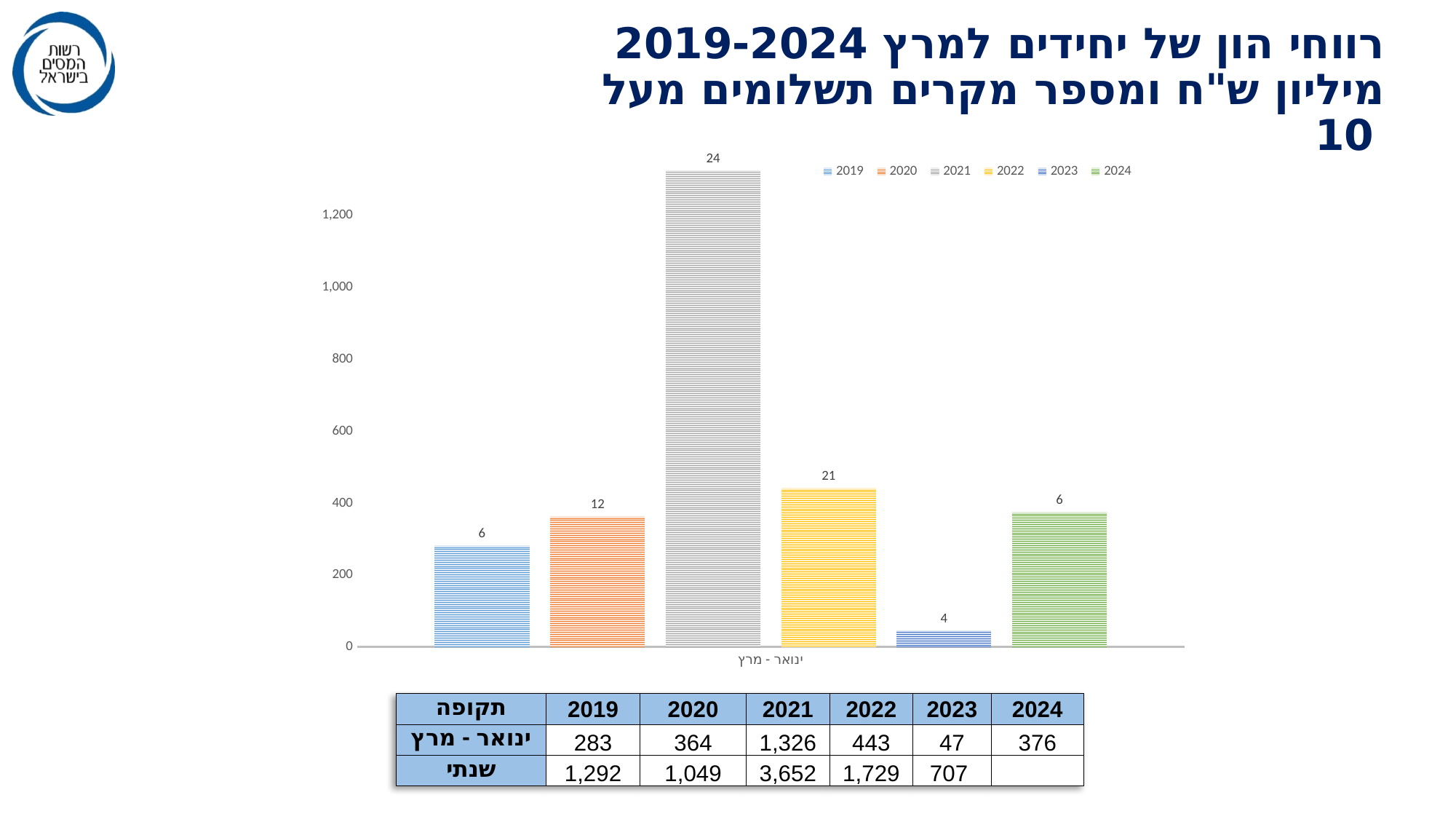
Which year's bar is the shortest in the chart? 2023 How many series does the chart legend list? 6 Which bar is taller, 2022 or 2020? 2022 What data label is printed above the 2021 bar? 24 What is the category label shown on the x axis of the chart? ינואר - מרץ Is the height of the 2021 bar greater or less than 1,200? greater What data label is printed above the 2022 bar? 21 Which year's bar is the tallest in the chart? 2021 What kind of chart is shown on the slide? bar chart Is the height of the 2023 bar greater or less than 200? less What is the difference between the data labels printed above the 2021 bar and the 2022 bar? 3 What data label is printed above the 2023 bar? 4